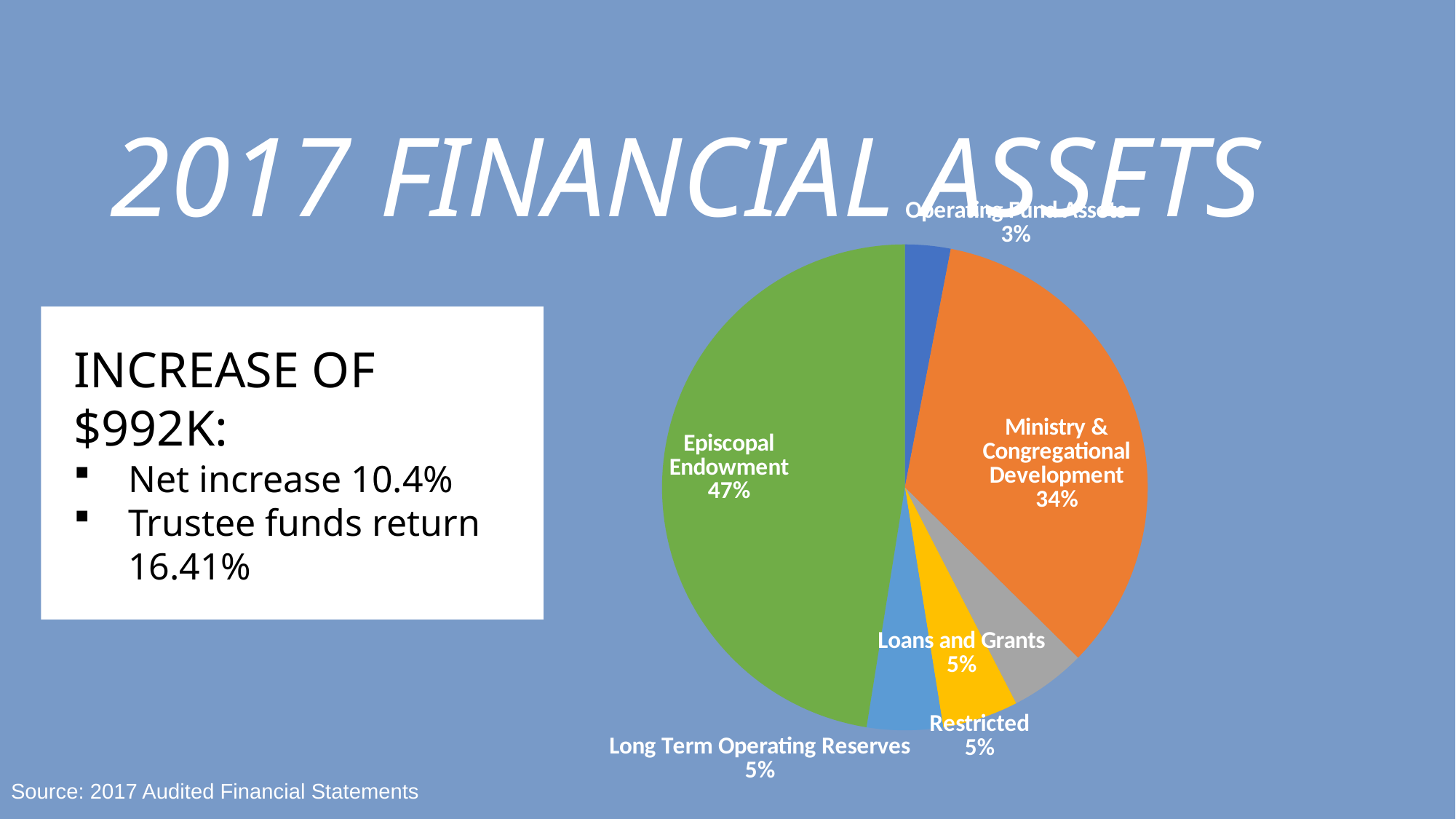
Which slice of the pie is the largest? Episcopal Endowment Which is larger, Ministry & Congregational Development or Restricted? Ministry & Congregational Development What colour is the Episcopal Endowment slice? Green What is the value shown for Restricted? 5% What kind of chart is shown on the slide? Pie chart What is the difference in percentage points between Episcopal Endowment and Ministry & Congregational Development? 13 What share of the pie does Ministry & Congregational Development represent? 34% Which slice of the pie is the smallest? Operating Fund Assets What is the value shown for Long Term Operating Reserves? 5% What is the value shown for Loans and Grants? 5% How many slices does the pie chart have? 6 What share of the pie does Episcopal Endowment represent? 47%